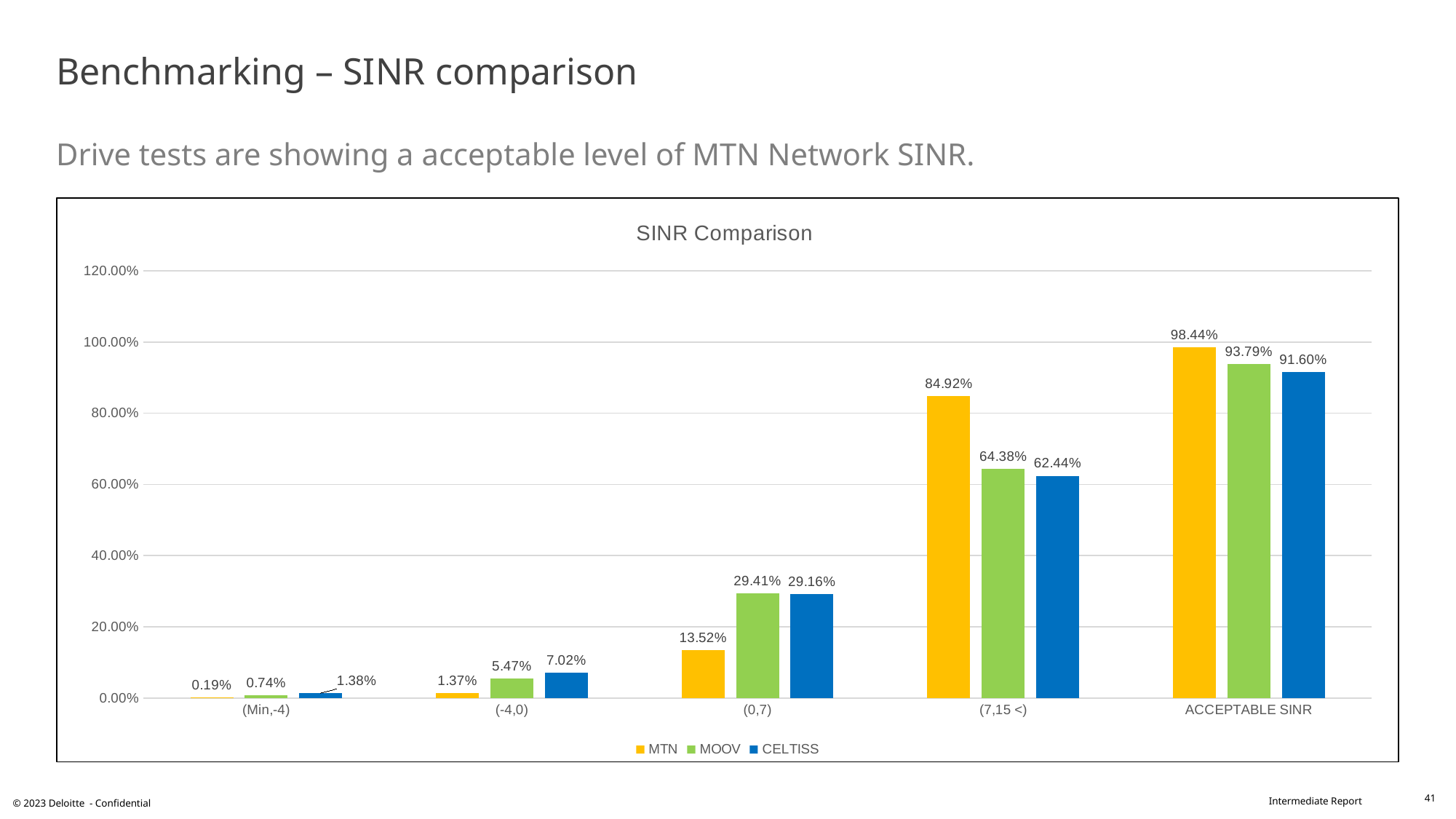
What is the MOOV value for the (0,7) category? 29.41% What is the MTN value for the ACCEPTABLE SINR category? 98.44% Which series has the lowest value in the (Min,-4) category? MTN Is the MOOV value for ACCEPTABLE SINR greater or less than 80.00%? greater How many categories are shown on the x axis? 5 What is the CELTISS value for the (7,15 <) category? 62.44% What kind of chart is shown on the slide? bar chart What is the difference between the MTN and MOOV values in the (7,15 <) category? 20.54% What is the title of the chart? SINR Comparison Which series has the highest value in the (7,15 <) category? MTN Which is larger in the (-4,0) category, the MOOV value or the CELTISS value? CELTISS How many series does the legend list? 3